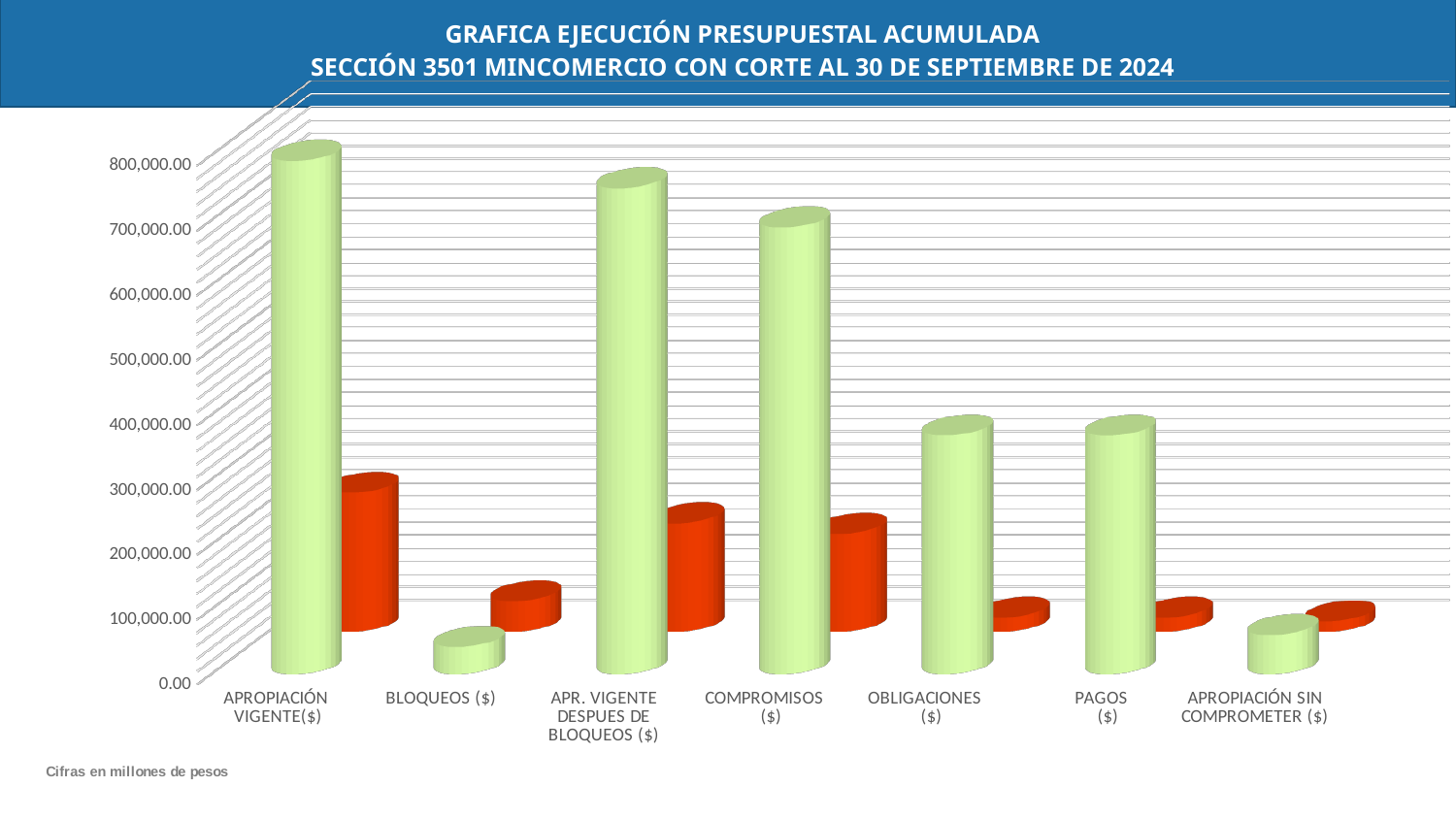
What is the highest value shown on the vertical axis of the chart? 800,000.00 Which category has the tallest green bar? APROPIACIÓN VIGENTE($) According to the note below the chart, in what units are the figures expressed? millones de pesos What kind of chart is shown on the slide? bar chart Is the red bar for APROPIACIÓN VIGENTE($) greater or less than 200,000.00? greater How many categories are shown on the x axis of the chart? 7 Which category has the tallest red bar? APROPIACIÓN VIGENTE($) Is the green bar for APROPIACIÓN VIGENTE($) greater or less than 700,000.00? greater Is the green bar for APR. VIGENTE DESPUES DE BLOQUEOS ($) greater or less than 700,000.00? greater Which green bar is taller, COMPROMISOS ($) or OBLIGACIONES ($)? COMPROMISOS ($)